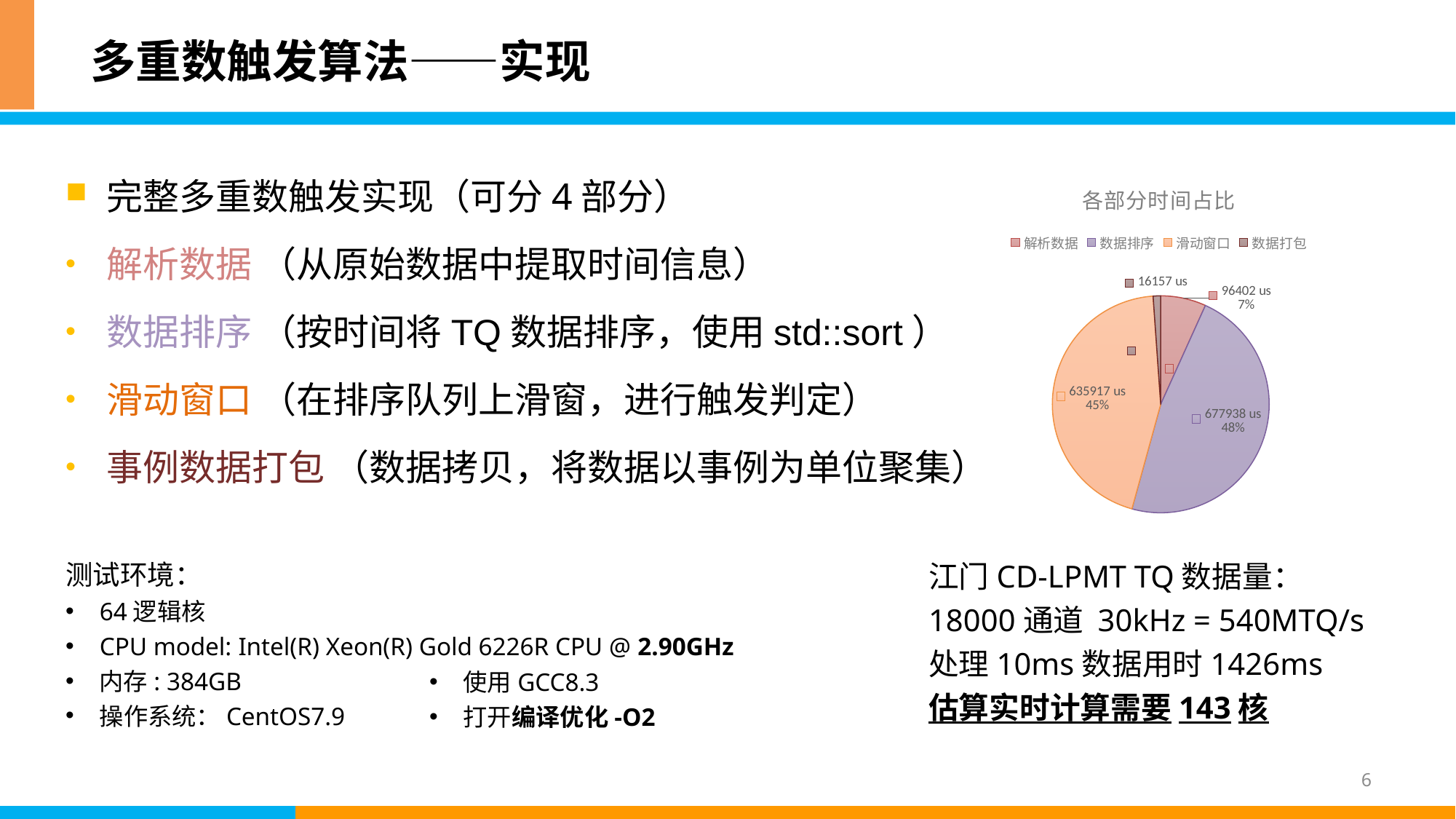
What is the difference between the values for 数据排序 and 滑动窗口? 42021 us Which category has the largest slice in the pie chart? 数据排序 What is the value for 解析数据 in the pie chart? 96402 us How many categories does the legend of the pie chart list? 4 What kind of chart is shown on the slide? pie chart What share of the pie does 数据排序 take? 48% What is the title of the chart? 各部分时间占比 What share of the pie does 滑动窗口 take? 45% Which category has the smallest slice in the pie chart? 数据打包 What is the value for 滑动窗口 in the pie chart? 635917 us What is the value for 数据排序 in the pie chart? 677938 us What is the value for 数据打包 in the pie chart? 16157 us